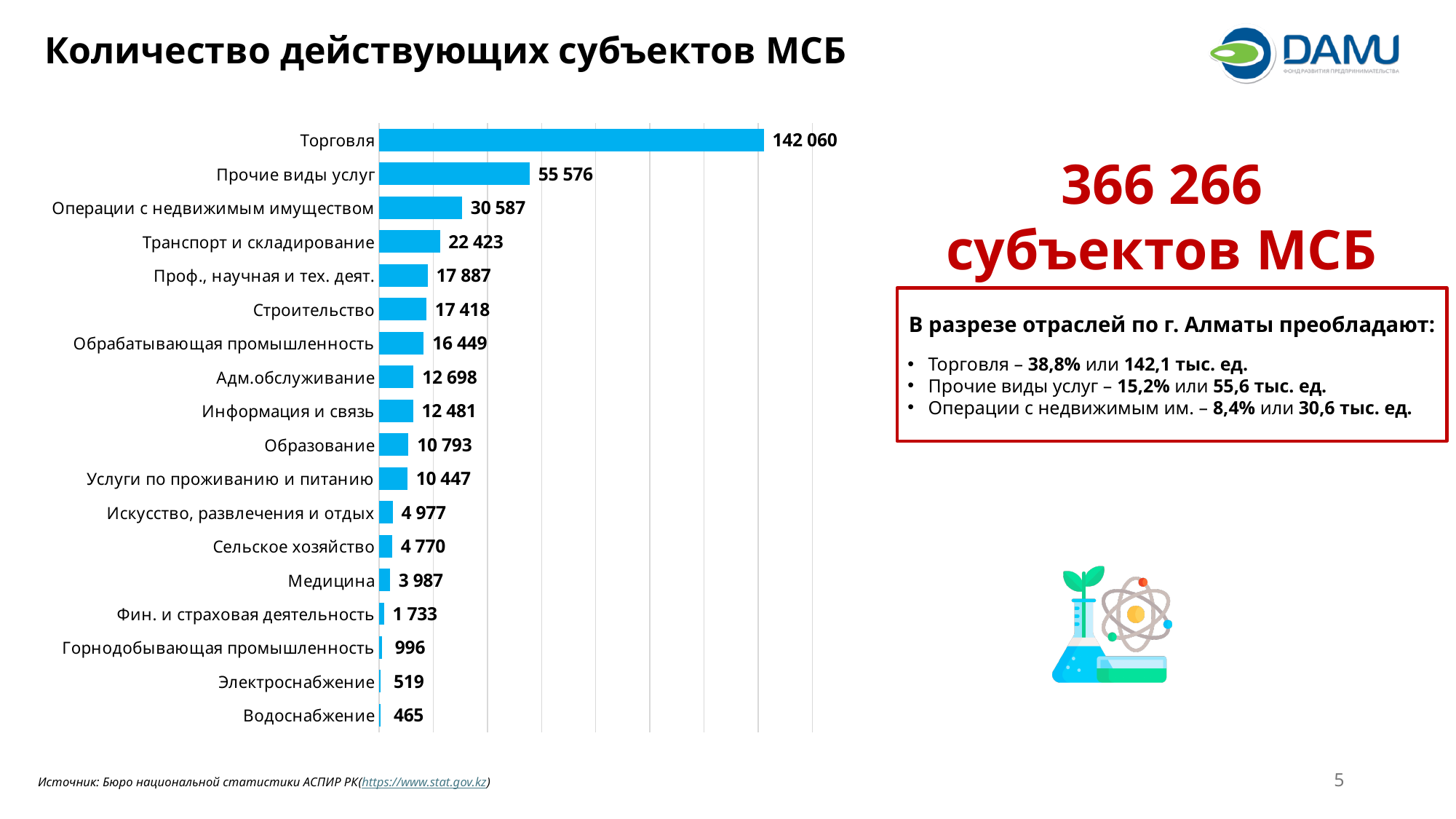
What is the difference between the values for Электроснабжение and Водоснабжение? 54 What kind of chart is shown on the slide? Bar chart What is the value for Транспорт и складирование? 22 423 How many categories are shown in the chart? 18 What is the value for Торговля? 142 060 What is the difference between the values for Торговля and Прочие виды услуг? 86 484 Which category has the lowest value? Водоснабжение Which is larger, the value for Строительство or the value for Обрабатывающая промышленность? Строительство What is the value for Образование? 10 793 Which category has the highest value? Торговля What is the title of the slide containing the chart? Количество действующих субъектов МСБ What is the value for Горнодобывающая промышленность? 996